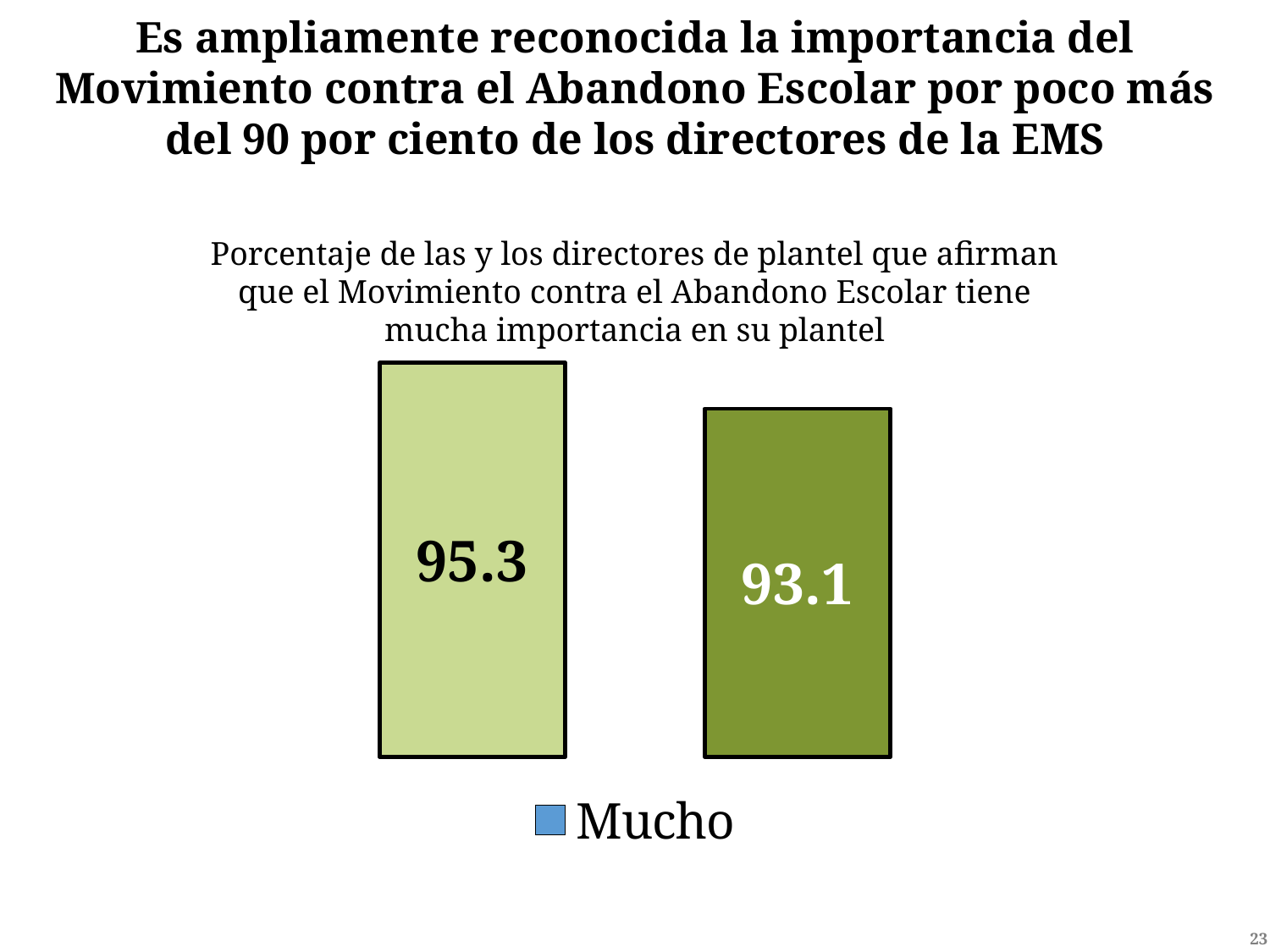
What is the value of the dark green bar? 93.1 How many bars are plotted in the chart? 2 Which is larger, the value of the light green bar or the dark green bar? light green bar What is the value of the light green bar? 95.3 How many series does the legend list? 1 Which bar has the highest value, the left or the right one? left What is the value shown on the right bar of the chart? 93.1 What is the difference between the values of the left bar and the right bar? 2.2 Which bar has the lowest value, the left or the right one? right What is the value shown on the left bar of the chart? 95.3 What kind of chart is shown on the slide? bar chart What is the legend entry of the chart? Mucho